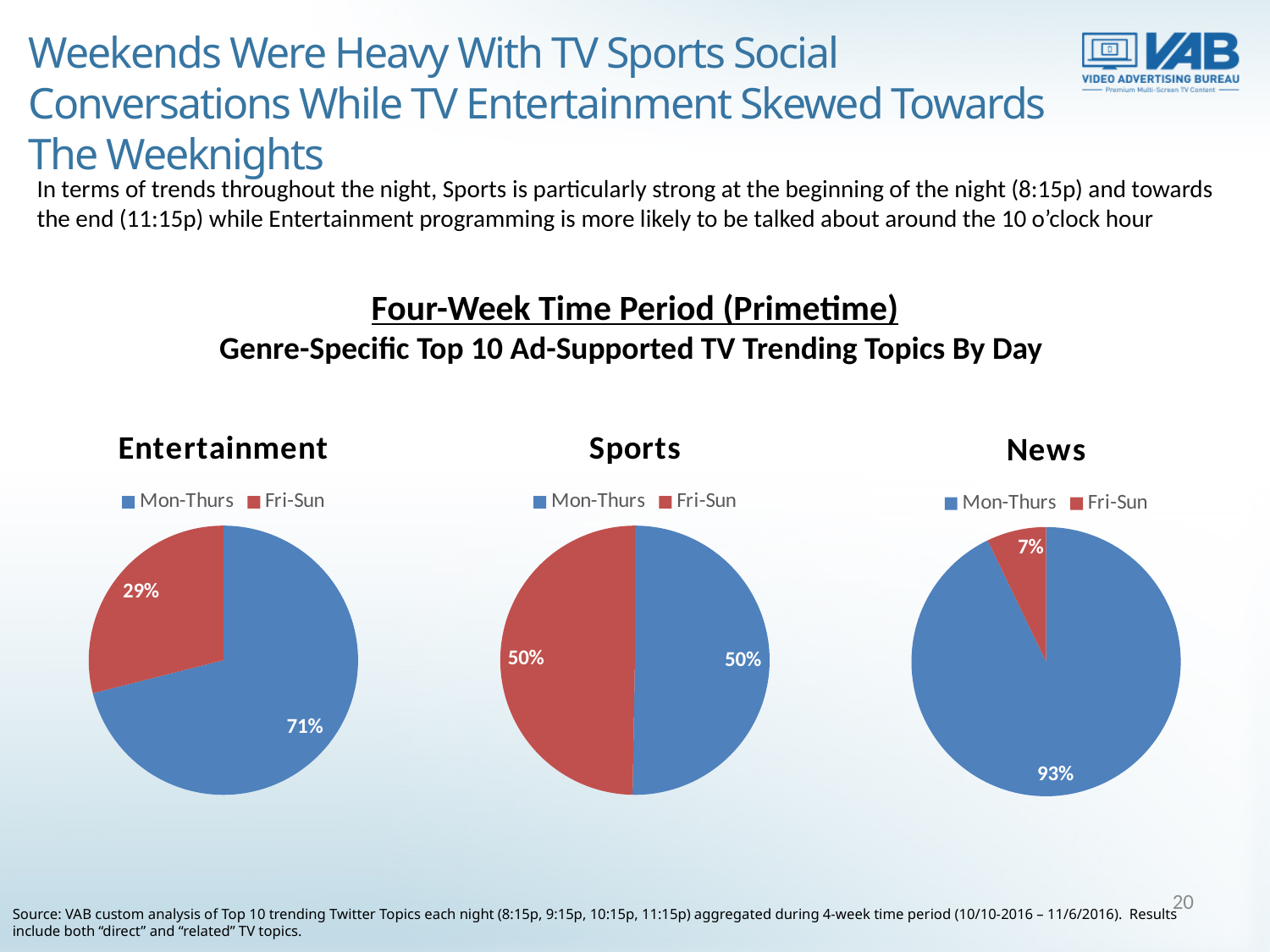
In the Sports pie chart, what share is Fri-Sun? 50% In the News pie chart, what is the difference between the Mon-Thurs and Fri-Sun shares? 86% What kind of chart is the Sports chart? Pie chart In the News pie chart, what share is Fri-Sun? 7% In the Entertainment pie chart, which slice is larger, Mon-Thurs or Fri-Sun? Mon-Thurs In the News pie chart, which slice is the smallest? Fri-Sun In the Entertainment pie chart, what is the difference between the Mon-Thurs and Fri-Sun shares? 42% How many slices does the Entertainment pie chart have? 2 How many entries does the legend of the News chart list? 2 In the Entertainment pie chart, what share is Mon-Thurs? 71% In the Entertainment pie chart, what share is Fri-Sun? 29% In the News pie chart, what share is Mon-Thurs? 93%